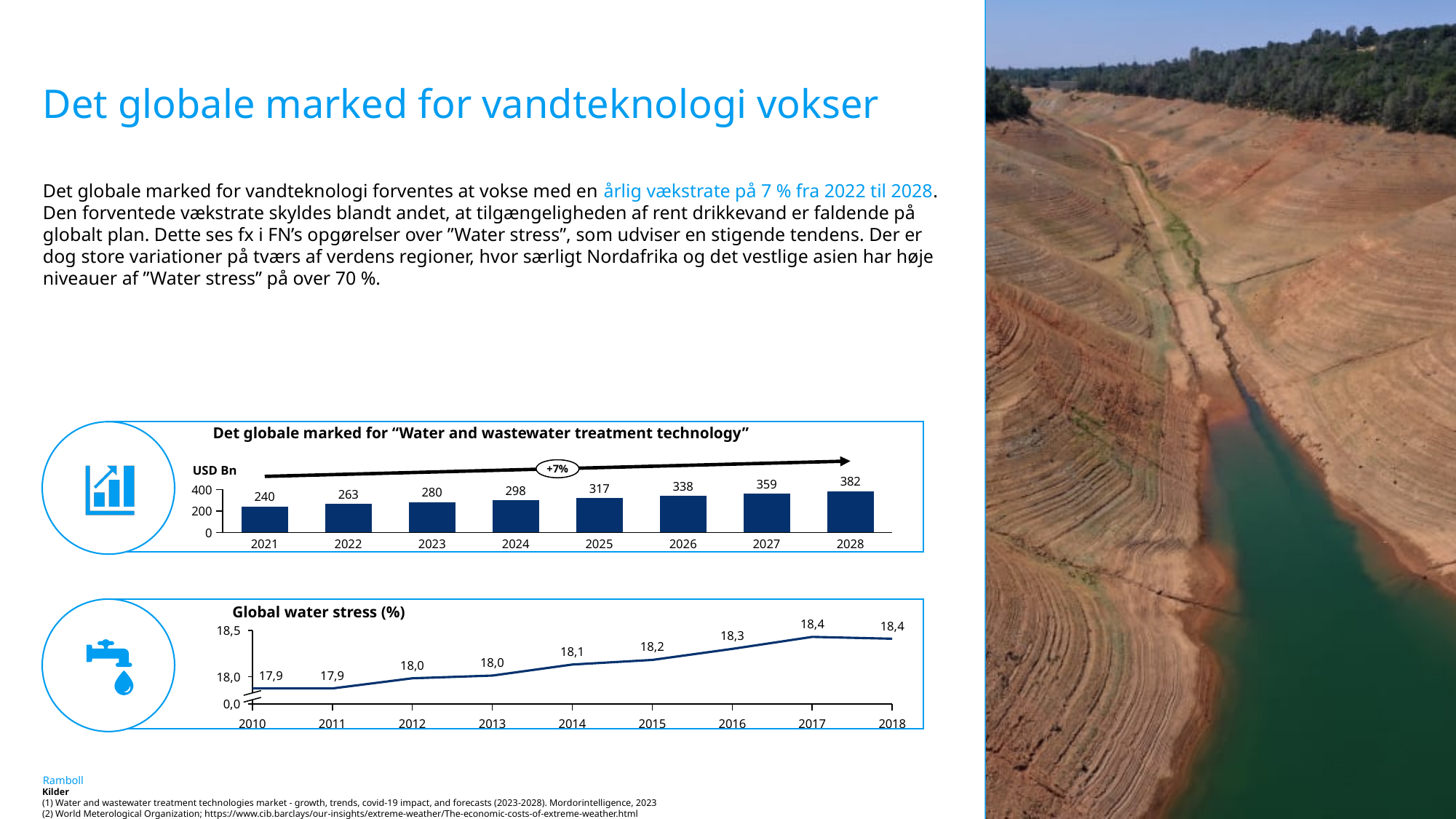
In the chart 'Global water stress (%)', which is larger, the value for 2016 or the value for 2012? 2016 In the chart 'Det globale marked for "Water and wastewater treatment technology"', what is the value for 2024? 298 In the chart 'Det globale marked for "Water and wastewater treatment technology"', what is the value for 2028? 382 In the chart 'Global water stress (%)', do the values rise or fall from 2010 to 2017? rise In the chart 'Global water stress (%)', what is the value for 2014? 18,1 In the chart 'Det globale marked for "Water and wastewater treatment technology"', how many years are shown on the x axis? 8 In the chart 'Global water stress (%)', what is the value for 2010? 17,9 What kind of chart is 'Global water stress (%)'? line chart In the chart 'Det globale marked for "Water and wastewater treatment technology"', which year has the lowest value? 2021 What kind of chart is 'Det globale marked for "Water and wastewater treatment technology"'? bar chart In the chart 'Det globale marked for "Water and wastewater treatment technology"', what annual growth rate is shown on the arrow? +7% In the chart 'Det globale marked for "Water and wastewater treatment technology"', what is the difference between the values for 2028 and 2021? 142